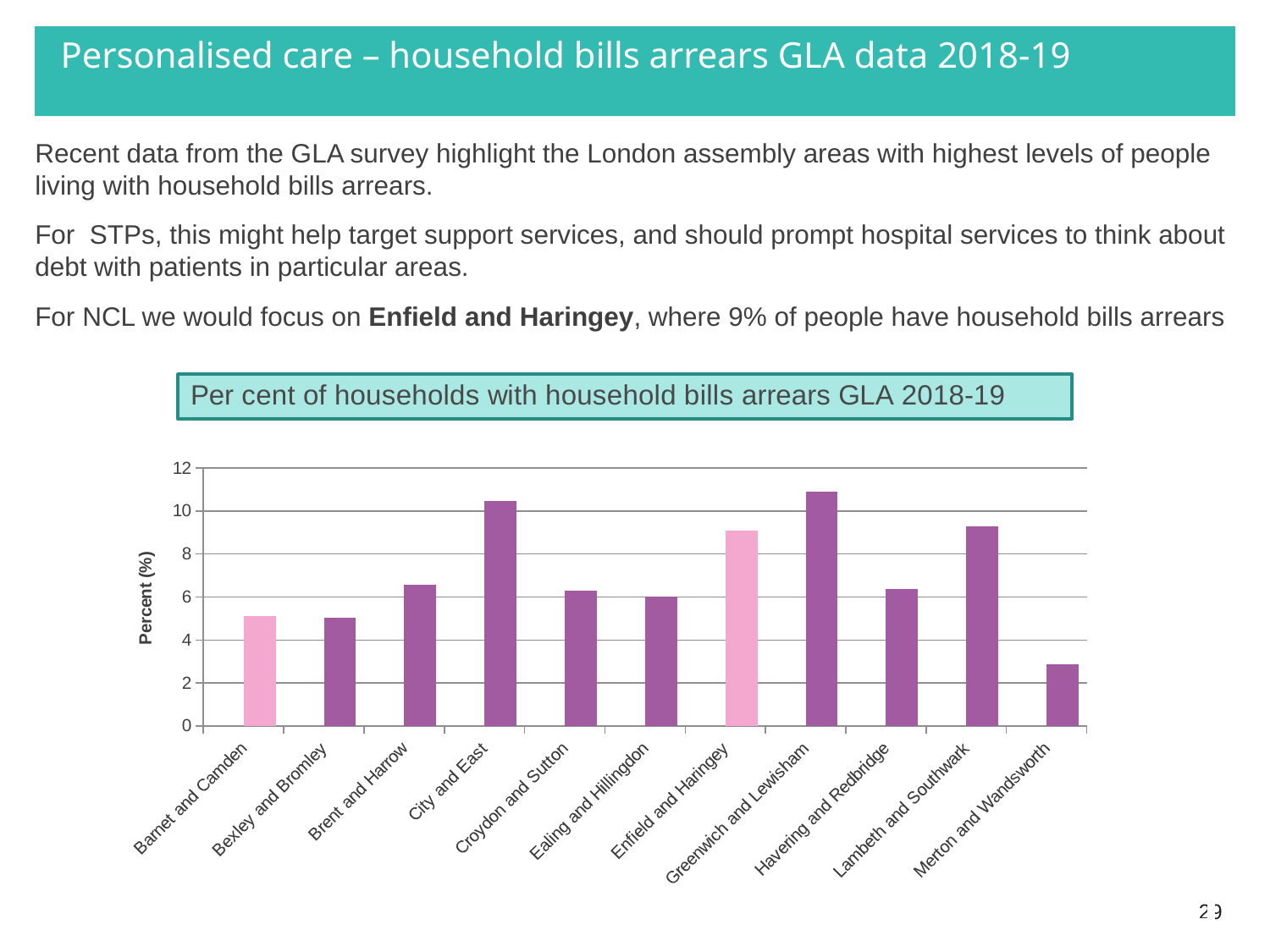
Which area has the lowest per cent of households with household bills arrears? Merton and Wandsworth Which is larger, the value for City and East or the value for Brent and Harrow? City and East Which is larger, the value for Barnet and Camden or the value for Merton and Wandsworth? Barnet and Camden Is the value for City and East greater or less than 10? greater Which two areas are shown with pink bars instead of purple? Barnet and Camden, Enfield and Haringey Which area has the highest per cent of households with household bills arrears? Greenwich and Lewisham What kind of chart is shown on the slide? Bar chart How many London assembly areas are shown on the x axis of the chart? 11 Is the value for Merton and Wandsworth greater or less than 4? less Is the value for Enfield and Haringey greater or less than 8? greater What is the title of the chart? Per cent of households with household bills arrears GLA 2018-19